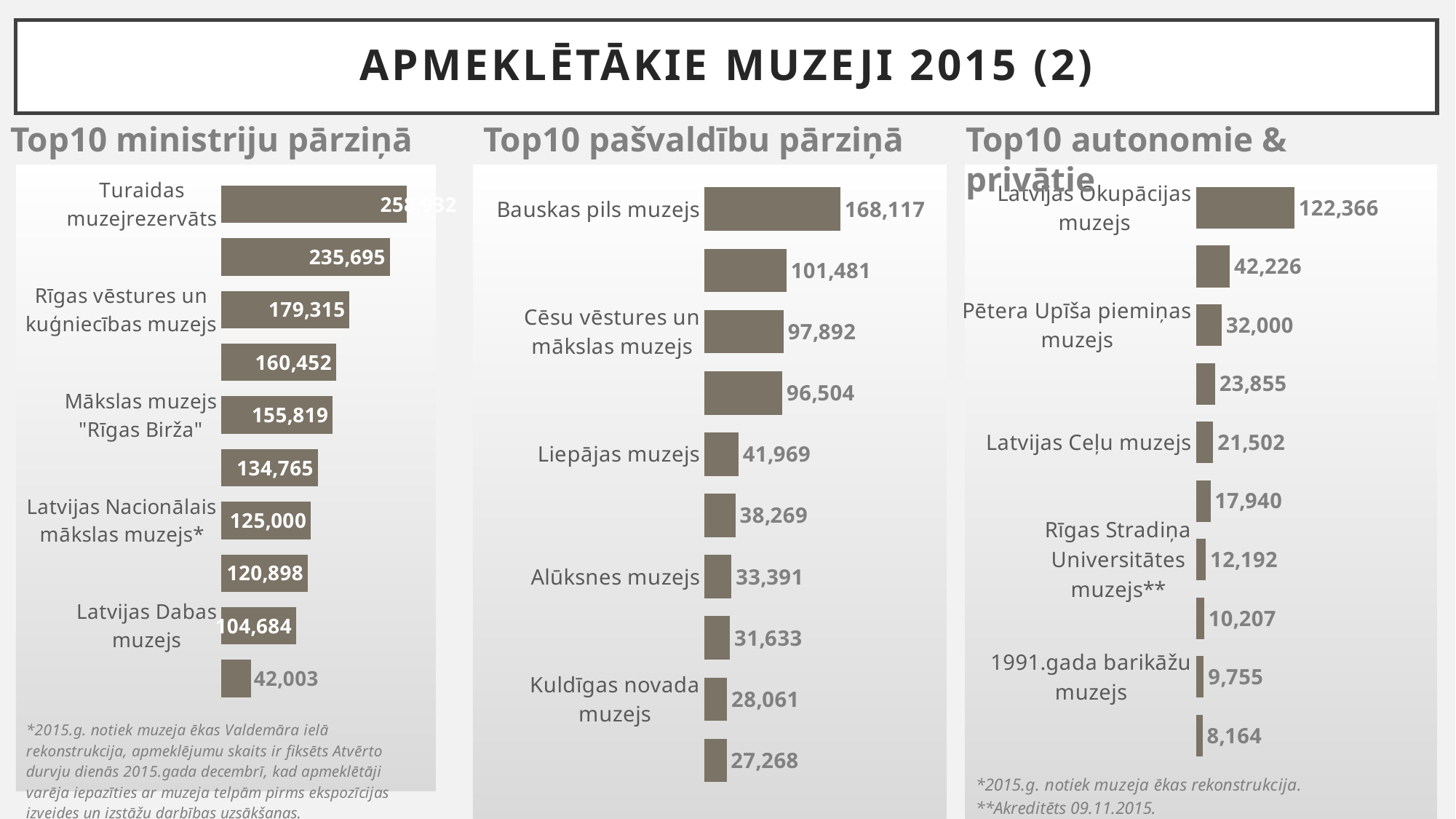
In the 'Top10 autonomie & privātie' chart, what is the difference between Latvijas Okupācijas muzejs and Latvijas Ceļu muzejs? 100,864 In the 'Top10 pašvaldību pārziņā' chart, which museum has the highest value? Bauskas pils muzejs In the 'Top10 ministriju pārziņā' chart, what is the value for Rīgas vēstures un kuģniecības muzejs? 179,315 In the 'Top10 autonomie & privātie' chart, what is the lowest value shown? 8,164 In the 'Top10 pašvaldību pārziņā' chart, what is the difference between Bauskas pils muzejs and Cēsu vēstures un mākslas muzejs? 70,225 In the 'Top10 pašvaldību pārziņā' chart, what is the value for Bauskas pils muzejs? 168,117 What type of chart is used for 'Top10 pašvaldību pārziņā'? Bar chart How many bars are shown in the 'Top10 ministriju pārziņā' chart? 10 In the 'Top10 ministriju pārziņā' chart, what is the value for Latvijas Dabas muzejs? 104,684 In the 'Top10 autonomie & privātie' chart, which museum has the highest value? Latvijas Okupācijas muzejs In the 'Top10 pašvaldību pārziņā' chart, which is larger: Liepājas muzejs or Alūksnes muzejs? Liepājas muzejs In the 'Top10 autonomie & privātie' chart, what is the value for Pētera Upīša piemiņas muzejs? 32,000